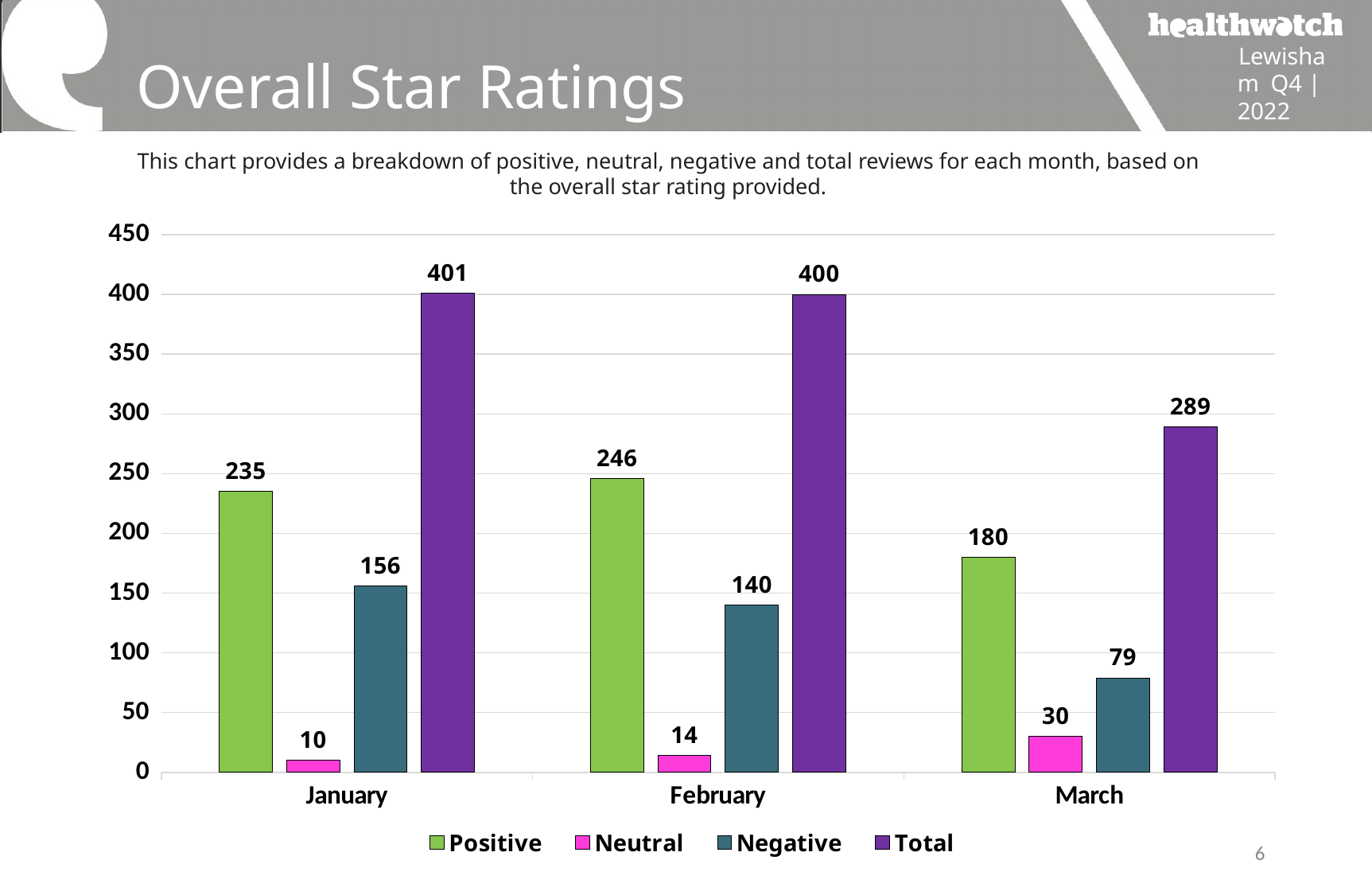
What is the difference between the Negative values for January and February? 16 How many series does the legend list? 4 How many months are shown on the x axis? 3 Does the Neutral value rise or fall from January to March? Rise Which is larger, the Positive value for February or the Positive value for January? February What is the Negative value for March? 79 Which month has the highest Total value? January What is the Neutral value for February? 14 What is the Positive value for January? 235 What is the Total value for February? 400 Which month has the lowest Positive value? March What kind of chart is shown on the slide? Bar chart